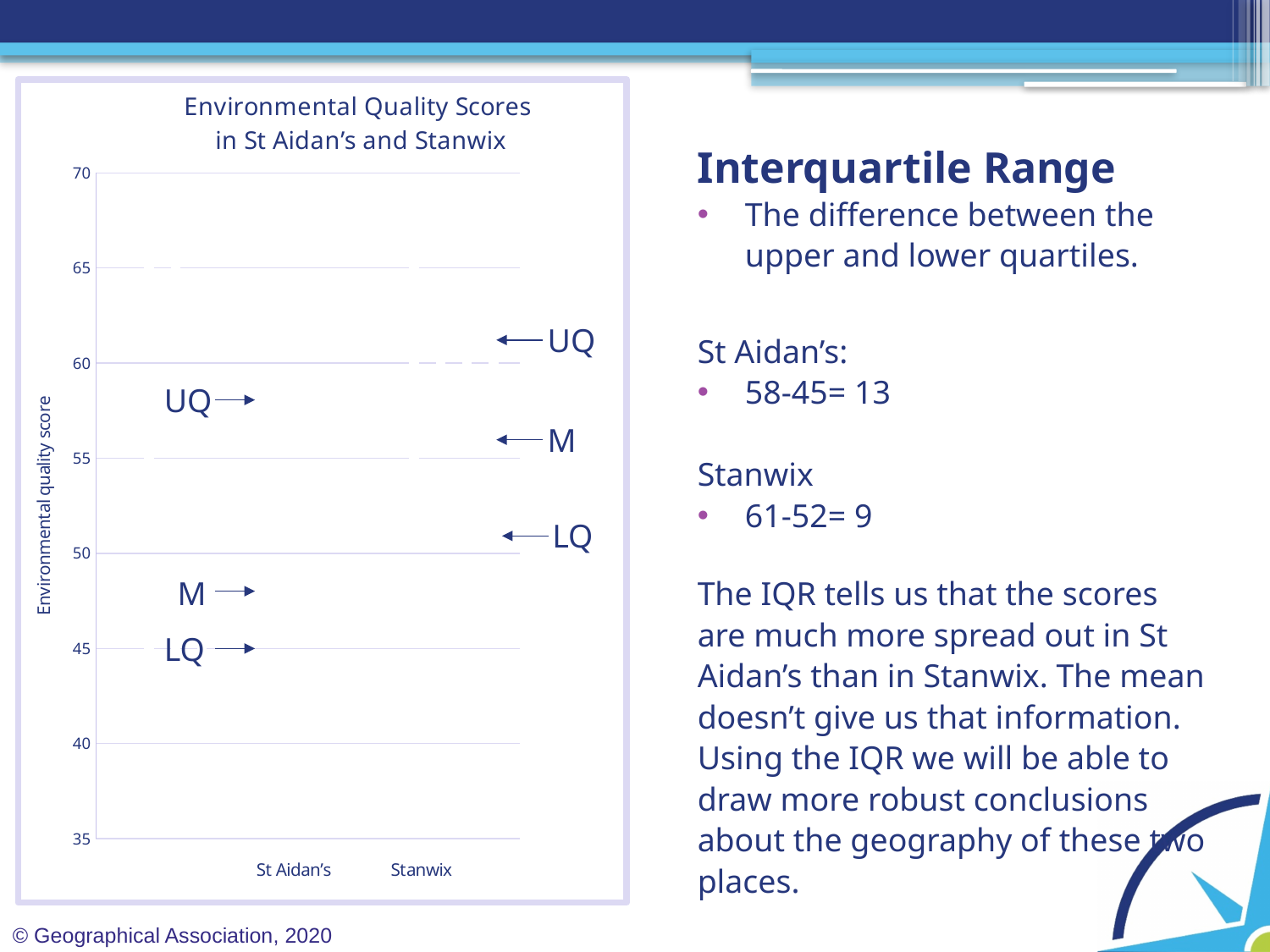
What is the title of the chart's vertical axis? Environmental quality score How many places are plotted on the chart? 2 What is the lower quartile (LQ) of environmental quality scores for St Aidan's? 45 What is the lower quartile (LQ) of environmental quality scores for Stanwix? 52 What is the interquartile range of environmental quality scores for St Aidan's? 13 Which place has the larger interquartile range, St Aidan's or Stanwix? St Aidan's What is the upper quartile (UQ) of environmental quality scores for St Aidan's? 58 Is the median (M) environmental quality score for Stanwix greater or less than 50? greater Which place has the higher upper quartile, St Aidan's or Stanwix? Stanwix What is the upper quartile (UQ) of environmental quality scores for Stanwix? 61 What is the interquartile range of environmental quality scores for Stanwix? 9 Is the median (M) environmental quality score for St Aidan's greater or less than 50? less